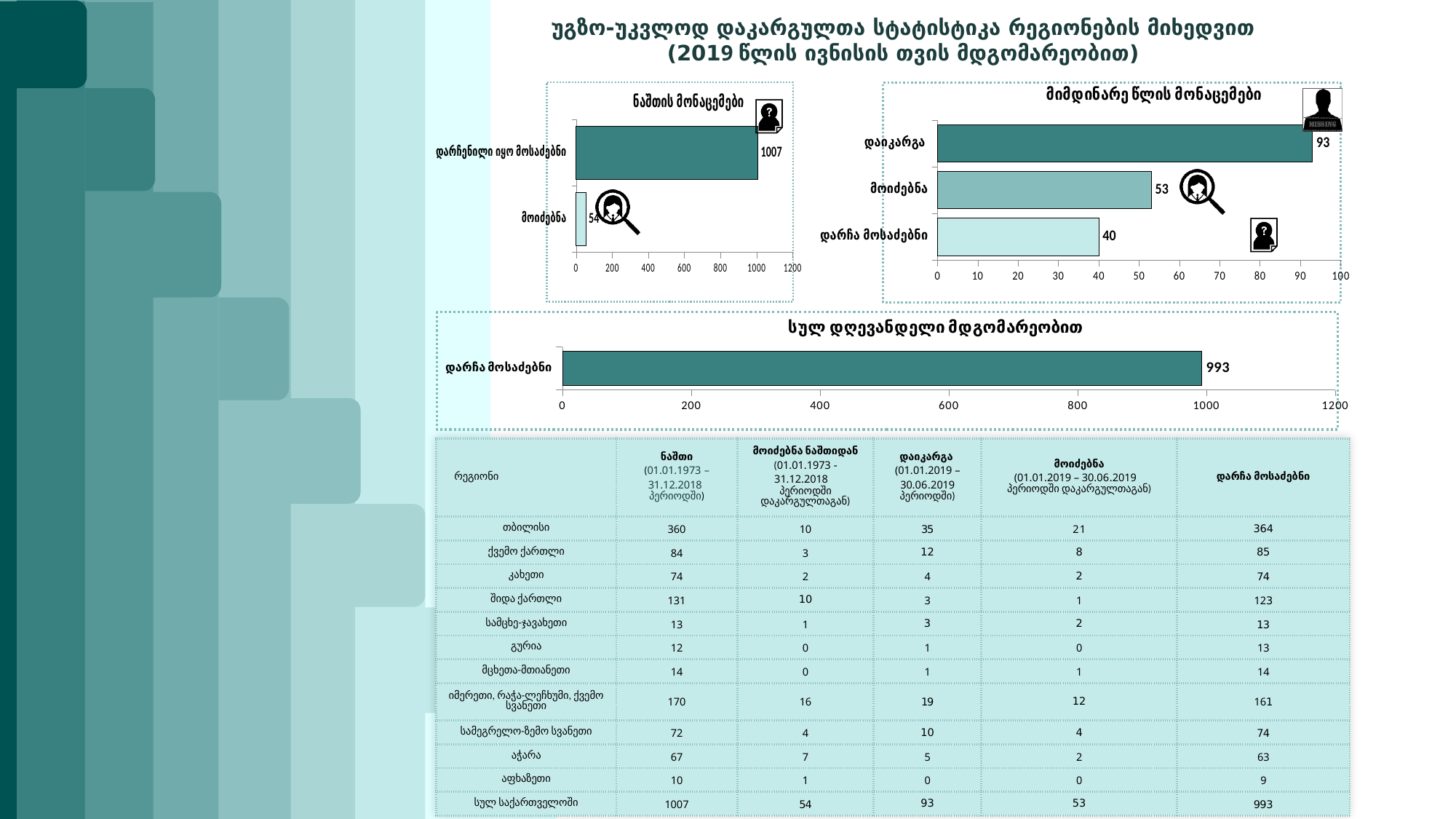
In the chart titled "ნაშთის მონაცემები" (top left), what is the difference between "დარჩენილი იყო მოსაძებნი" and "მოიძებნა"? 953 In the chart titled "მიმდინარე წლის მონაცემები" (top right), what is the difference between "დაიკარგა" and "მოიძებნა"? 40 In the chart titled "სულ დღევანდელი მდგომარეობით" (bottom), what is the value for "დარჩა მოსაძებნი"? 993 In the chart titled "მიმდინარე წლის მონაცემები" (top right), what is the value for "დაიკარგა"? 93 In the chart titled "ნაშთის მონაცემები" (top left), which is larger: "დარჩენილი იყო მოსაძებნი" or "მოიძებნა"? დარჩენილი იყო მოსაძებნი In the chart titled "მიმდინარე წლის მონაცემები" (top right), which category has the lowest value? დარჩა მოსაძებნი In the chart titled "ნაშთის მონაცემები" (top left), what is the value for "დარჩენილი იყო მოსაძებნი"? 1007 In the chart titled "მიმდინარე წლის მონაცემები" (top right), which category has the highest value? დაიკარგა What kind of chart is the one titled "სულ დღევანდელი მდგომარეობით" (bottom)? bar chart In the chart titled "მიმდინარე წლის მონაცემები" (top right), what is the value for "დარჩა მოსაძებნი"? 40 In the chart titled "ნაშთის მონაცემები" (top left), what is the value for "მოიძებნა"? 54 In the chart titled "მიმდინარე წლის მონაცემები" (top right), how many categories are plotted? 3